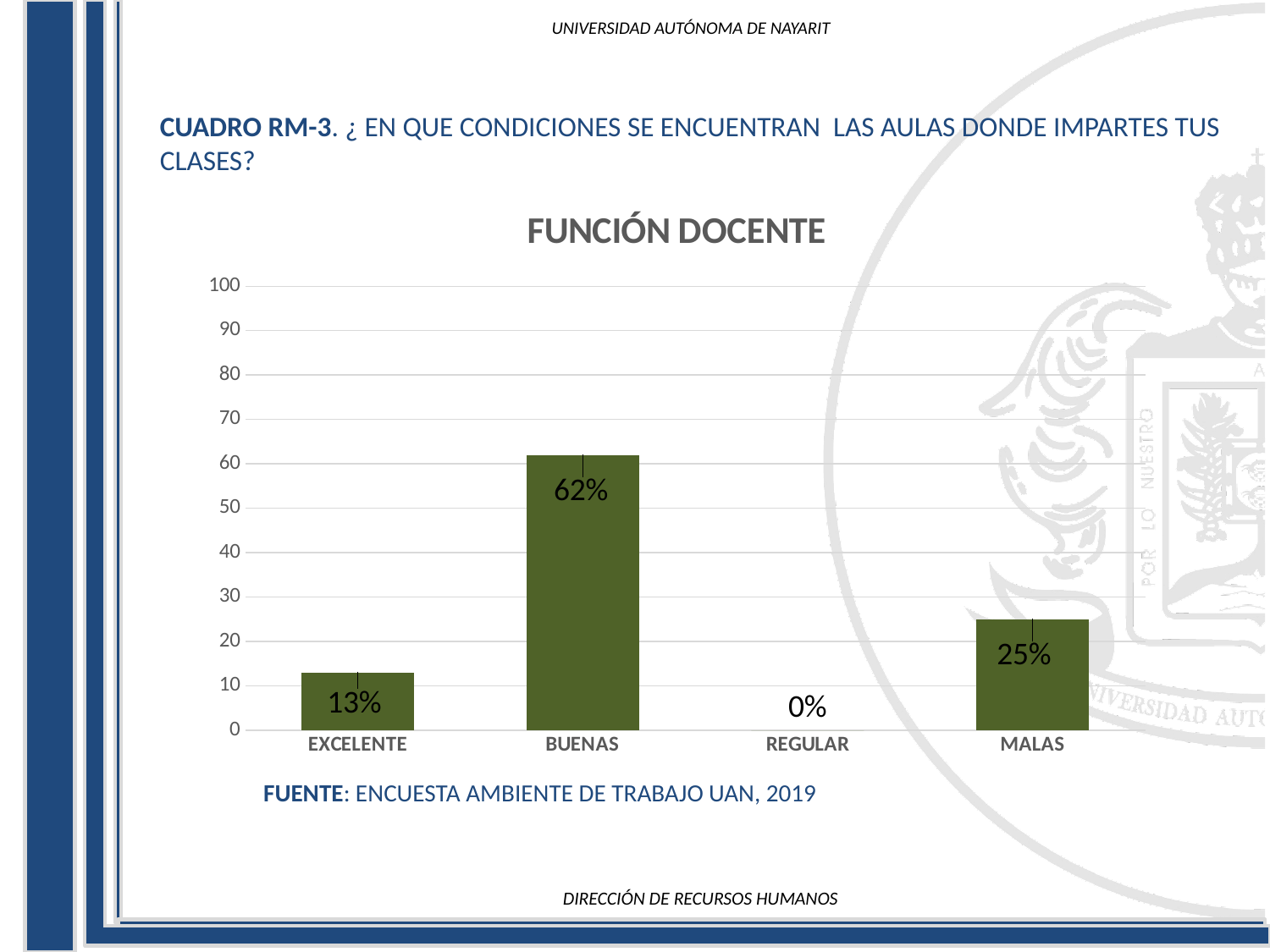
What is the value for MALAS? 25% How many categories are shown on the x axis? 4 What is the value for BUENAS? 62% What is the value for EXCELENTE? 13% Which is larger, the value for MALAS or the value for EXCELENTE? MALAS What is the value for REGULAR? 0% Which category has the lowest value? REGULAR What kind of chart is shown? bar chart What is the difference between the values for BUENAS and MALAS? 37% Which category has the highest value? BUENAS What is the title of the chart? FUNCIÓN DOCENTE Is the value for BUENAS greater or less than 50? greater